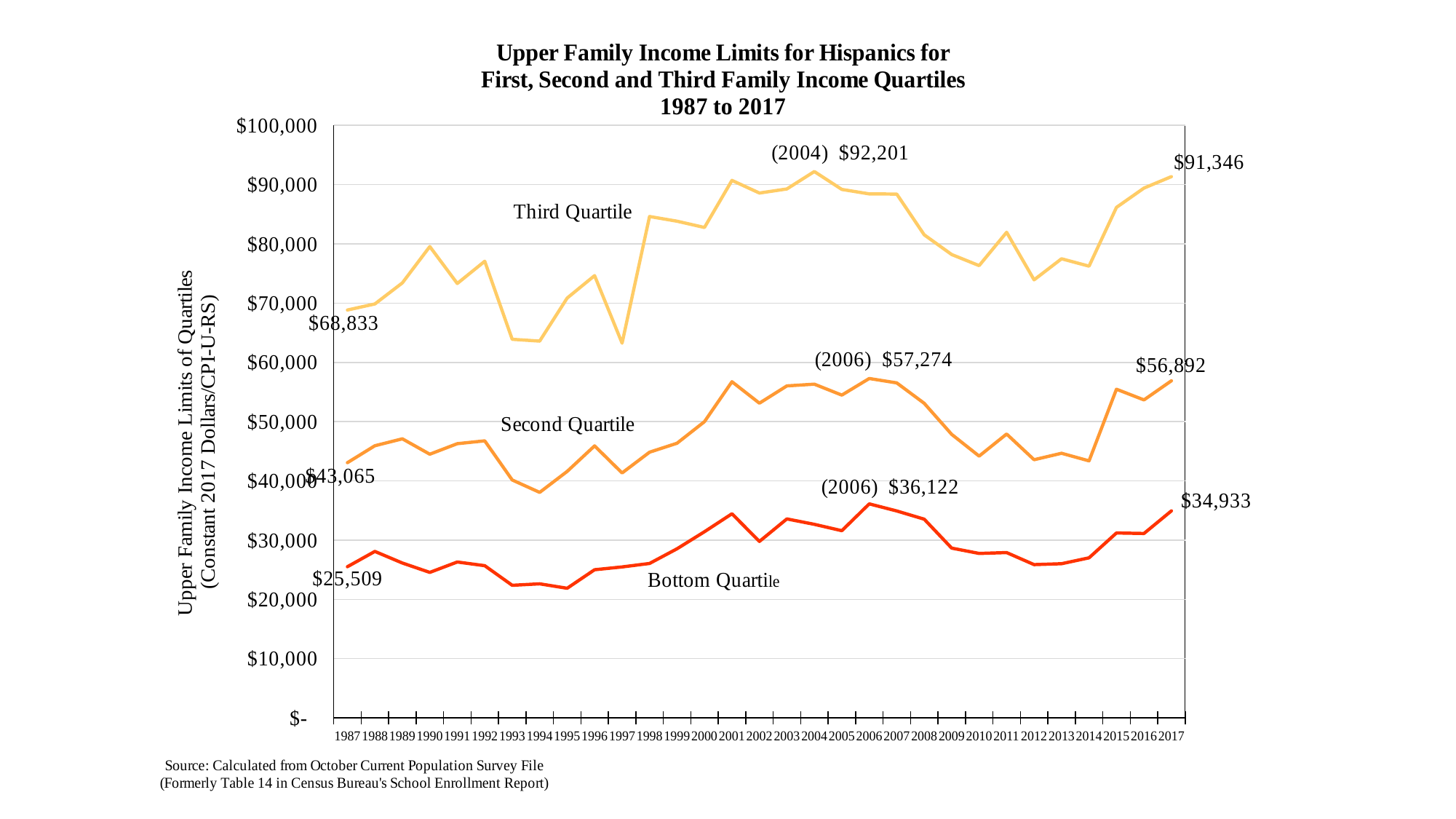
Is the Third Quartile value for 1997 greater or less than $70,000? less How many lines (quartile series) are plotted on the chart? 3 How much higher is the Third Quartile value in 2017 than in 1987? $22,513 What is the Third Quartile value in 2017? $91,346 What is the Second Quartile value in 2006? $57,274 What is the difference between the Second Quartile values in 2017 and 1987? $13,827 What is the Bottom Quartile value in 1987? $25,509 What is the Third Quartile upper family income limit for Hispanics in 1987? $68,833 What type of chart is shown on the slide? Line chart Which is larger: the Third Quartile value in 2004 or in 2017? 2004 What is the peak Third Quartile value labeled for 2004? $92,201 What is the Bottom Quartile value in 2017? $34,933